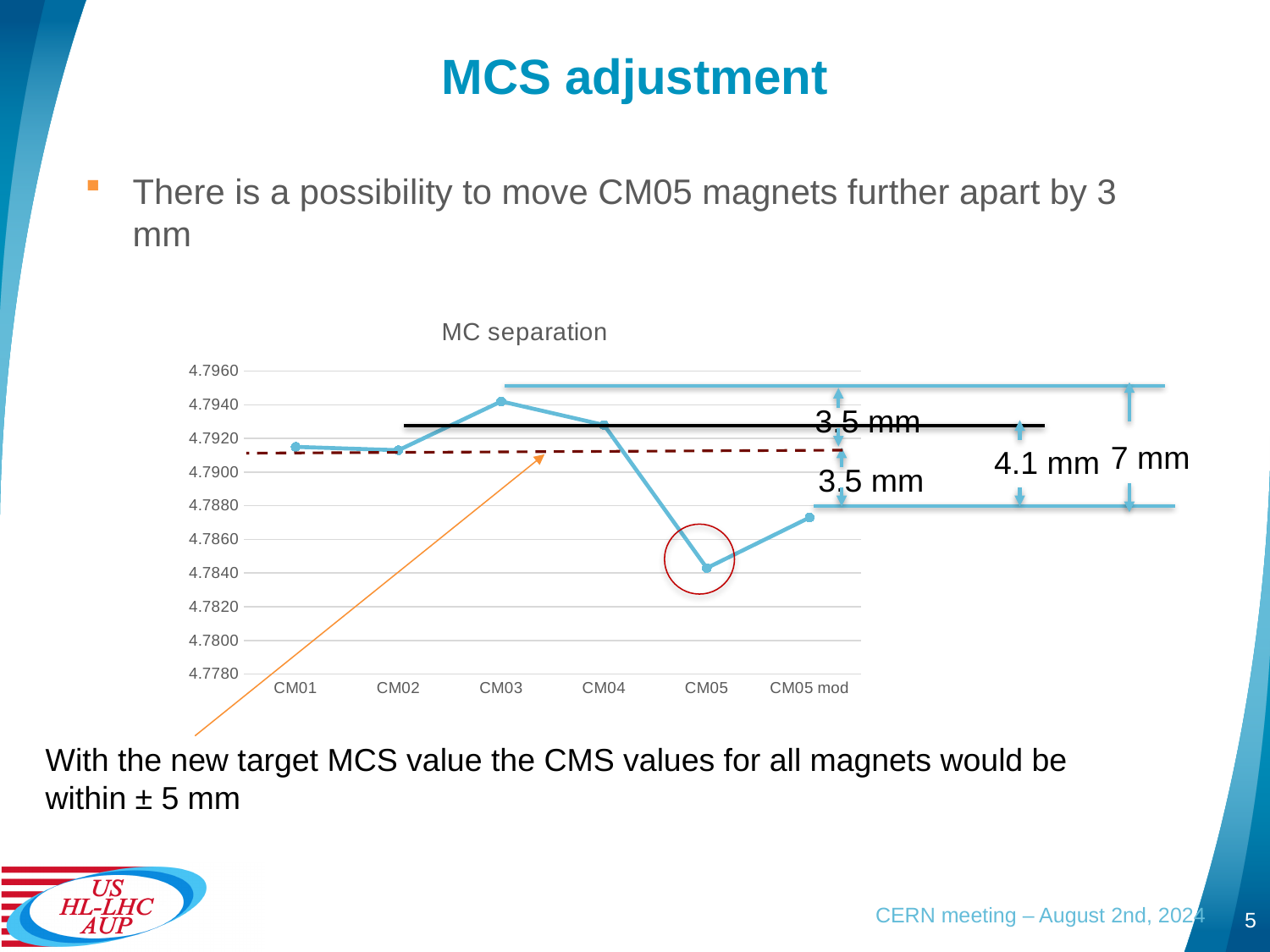
Which has the larger value, CM03 or CM05? CM03 Which category has the highest value in the MC separation chart? CM03 Which category has the lowest value in the MC separation chart? CM05 Does the line rise or fall from CM05 to CM05 mod? rise How many categories are plotted along the x axis of the chart? 6 What kind of chart is shown on the slide? line chart Is the value for CM03 greater or less than 4.7920? greater Is the value for CM05 greater or less than 4.7860? less What is the title of the chart? MC separation Does the line rise or fall from CM04 to CM05? fall Which has the larger value, CM04 or CM05 mod? CM04 Is the value for CM05 mod greater or less than 4.7900? less